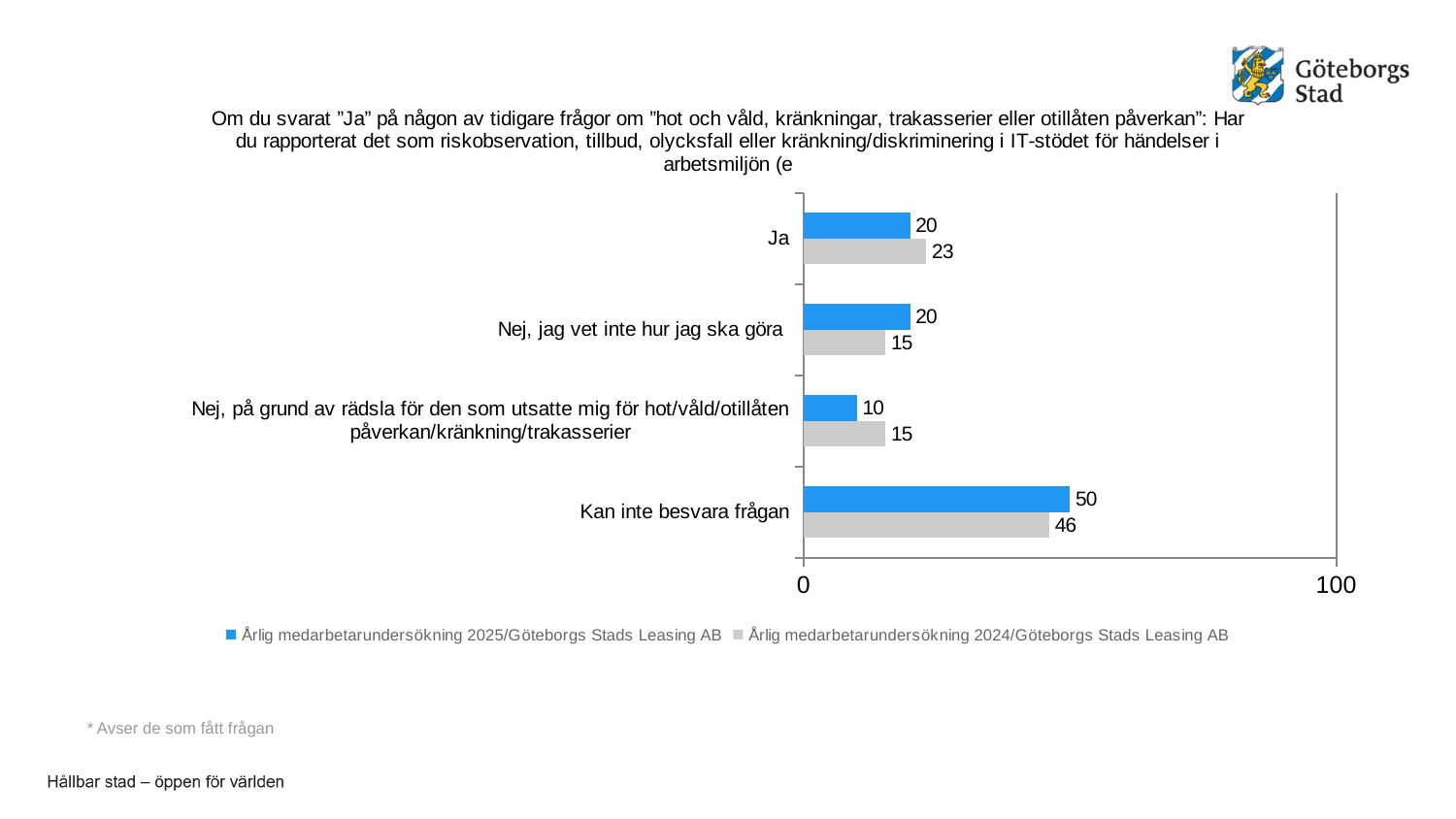
Which category has the lowest value in the 2025 series? Nej, på grund av rädsla för den som utsatte mig för hot/våld/otillåten påverkan/kränkning/trakasserier What kind of chart is shown on the slide? Bar chart How many series does the legend list? 2 What is the 2024 value for "Nej, jag vet inte hur jag ska göra"? 15 What is the difference between the 2025 and 2024 values for "Kan inte besvara frågan"? 4 For "Ja", which series has the larger value, 2025 or 2024? Årlig medarbetarundersökning 2024/Göteborgs Stads Leasing AB What is the value for "Kan inte besvara frågan" in the Årlig medarbetarundersökning 2024/Göteborgs Stads Leasing AB series? 46 What colour are the bars for the Årlig medarbetarundersökning 2025/Göteborgs Stads Leasing AB series? Blue How many categories are shown on the chart? 4 What is the 2025 value for "Nej, på grund av rädsla för den som utsatte mig för hot/våld/otillåten påverkan/kränkning/trakasserier"? 10 Which category has the highest value in the 2025 series? Kan inte besvara frågan What is the value for "Ja" in the Årlig medarbetarundersökning 2025/Göteborgs Stads Leasing AB series? 20